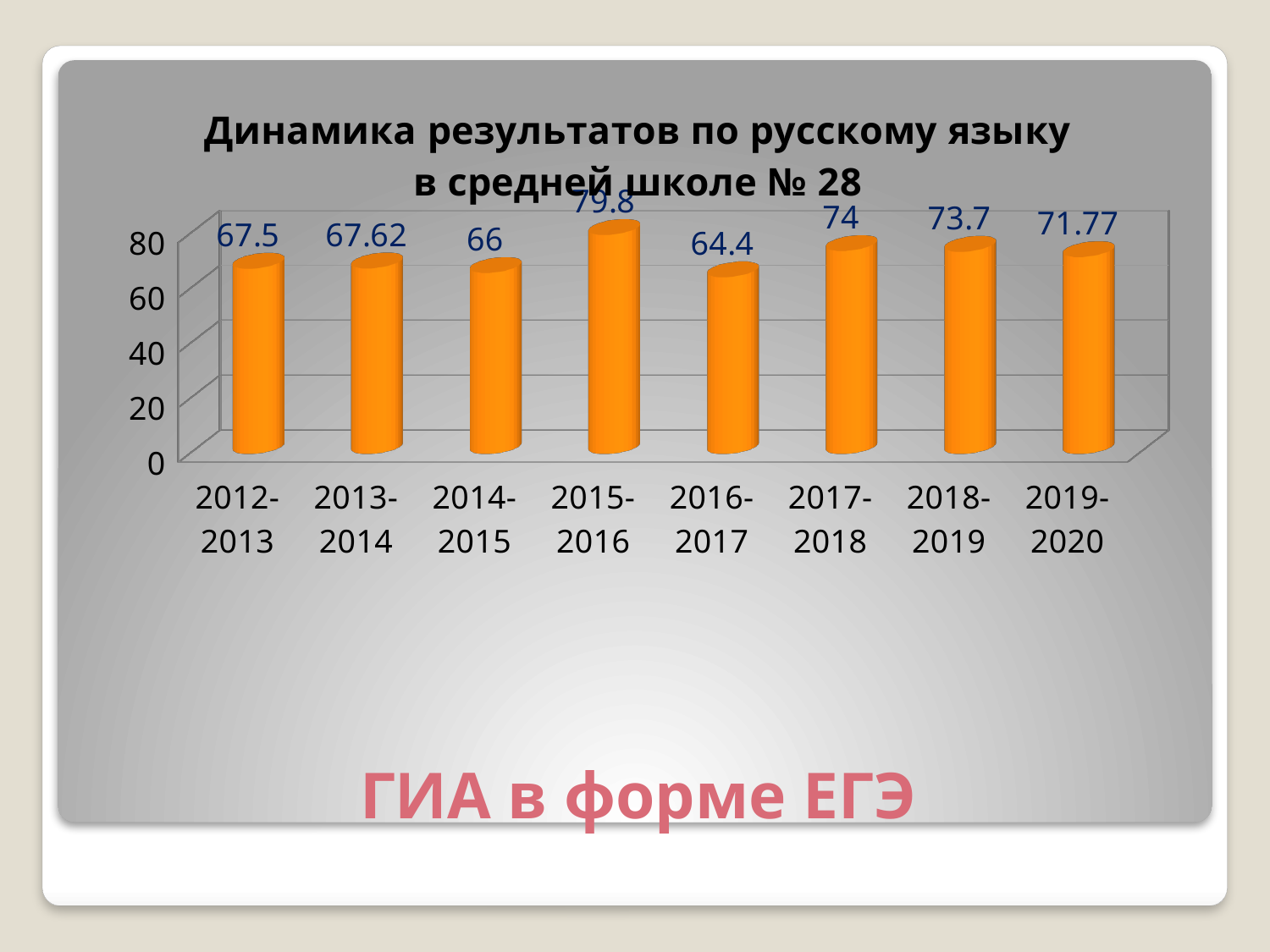
What kind of chart is shown on the slide? bar chart Which is larger, the value for 2017-2018 or the value for 2018-2019? 2017-2018 What is the difference between the values for 2015-2016 and 2016-2017? 15.4 What is the value for 2013-2014? 67.62 What is the value for 2015-2016? 79.8 Does the value rise or fall from 2018-2019 to 2019-2020? fall What is the title of the chart? Динамика результатов по русскому языку в средней школе № 28 Which school year has the lowest value? 2016-2017 What is the value for 2019-2020? 71.77 How many school years are shown on the x axis? 8 Is the value for 2014-2015 greater or less than 60? greater Which school year has the highest value? 2015-2016